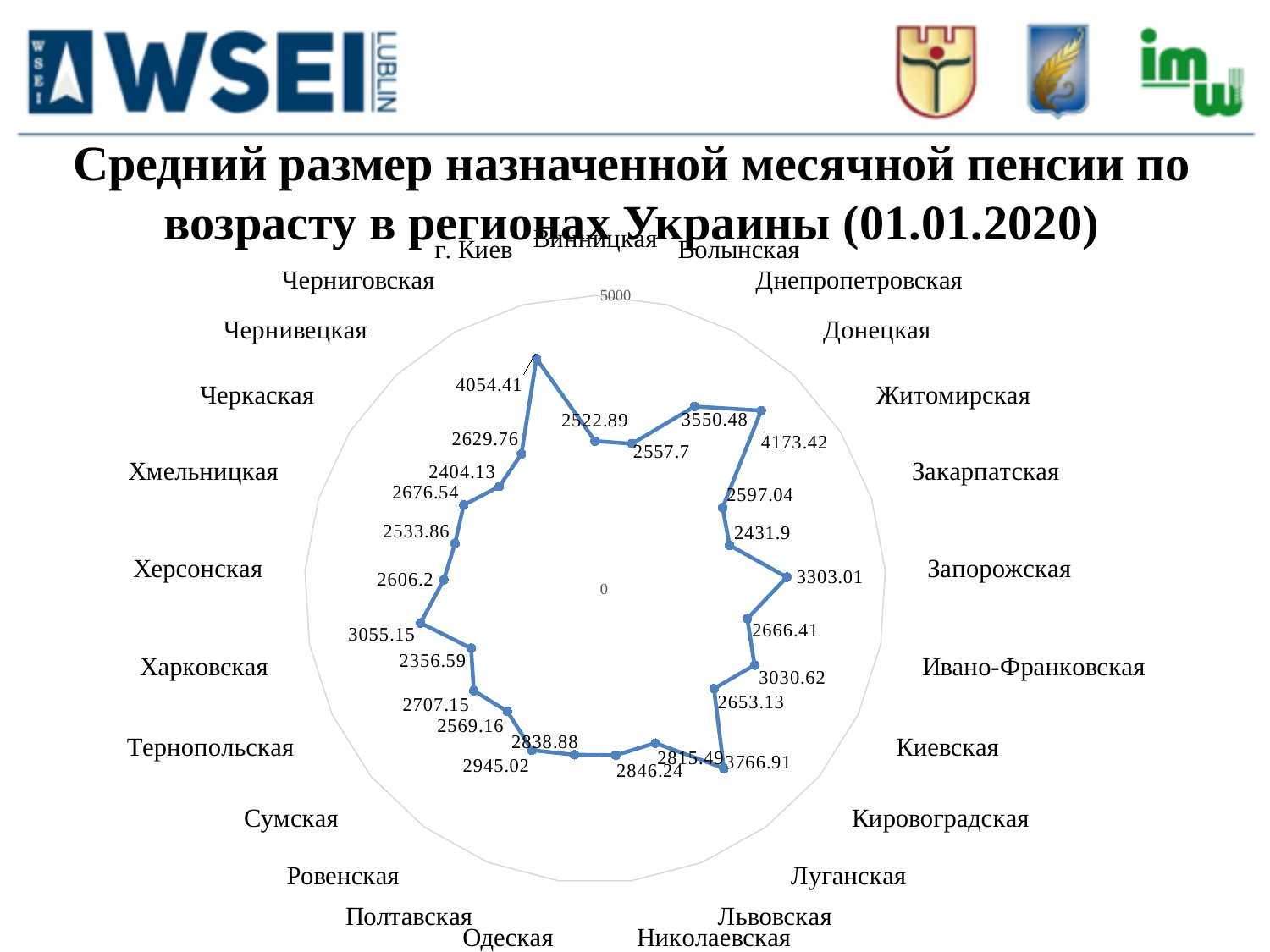
What is the difference between the values for Донецкая and г. Киев? 119.01 Which region has the highest average pension value on the chart? Донецкая Which has a larger value, Луганская or Днепропетровская? Луганская What is the value shown for Луганская? 3766.91 What is the value shown for Запорожская? 3303.01 What is the value shown for Донецкая? 4173.42 What type of chart is shown on the slide? radar chart What is the maximum value shown on the chart's radial axis? 5000 Which region has the lowest average pension value on the chart? Тернопольская How many regions (categories) are plotted on the chart? 25 What is the value shown for Тернопольская? 2356.59 What is the value shown for г. Киев? 4054.41